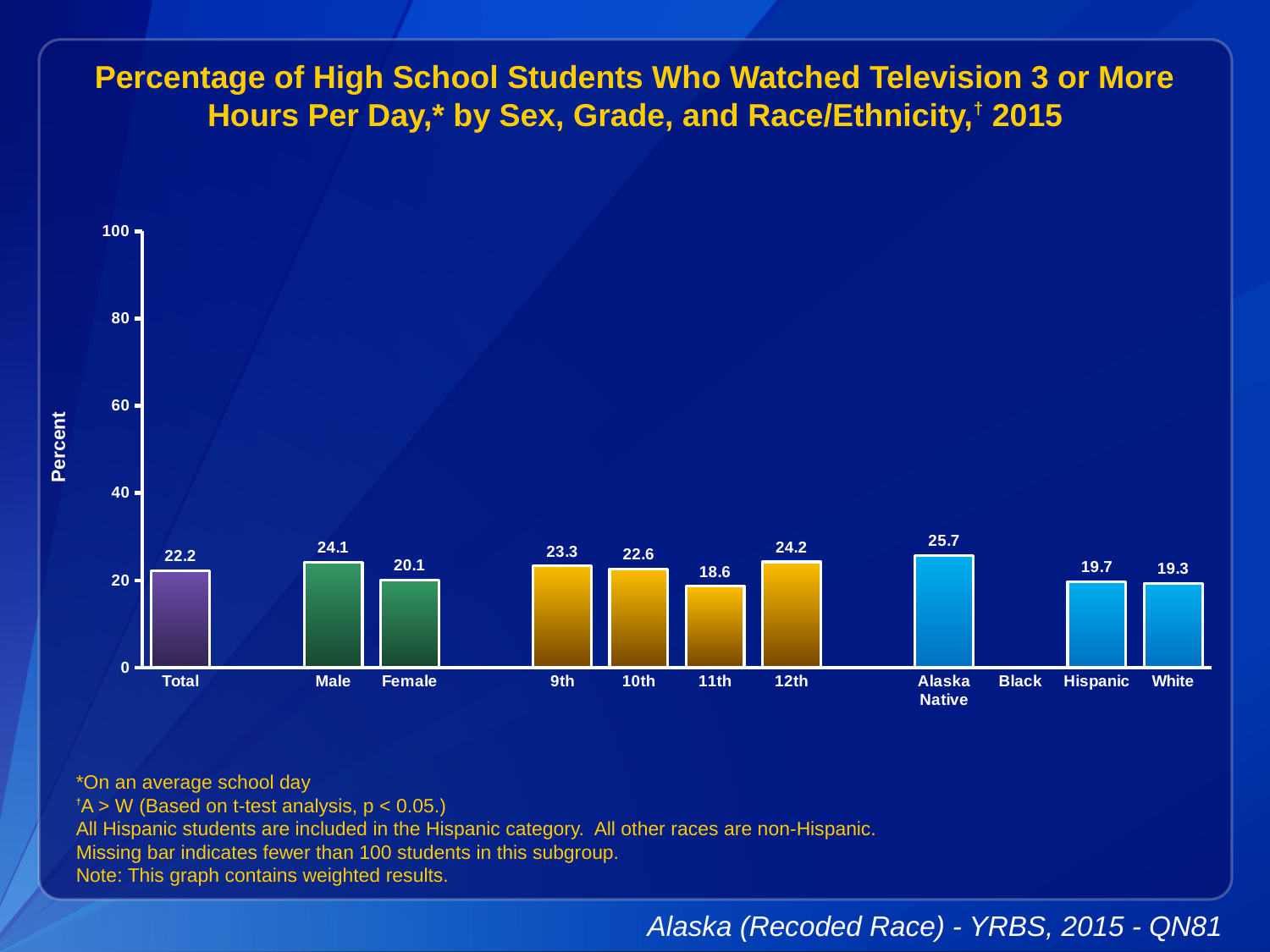
What is the value for Alaska Native? 25.7 Which is larger, the value for 9th grade or 10th grade? 9th What is the difference between the Male and Female values? 4.0 Is the value for 12th grade greater or less than 40? less What is the value for 11th grade? 18.6 Which category has the highest value? Alaska Native What is the value for Male? 24.1 What is the value for Total? 22.2 Which category has no bar shown? Black What type of chart is shown? bar chart Which category has the lowest value among the bars shown? 11th What is the label of the y axis? Percent